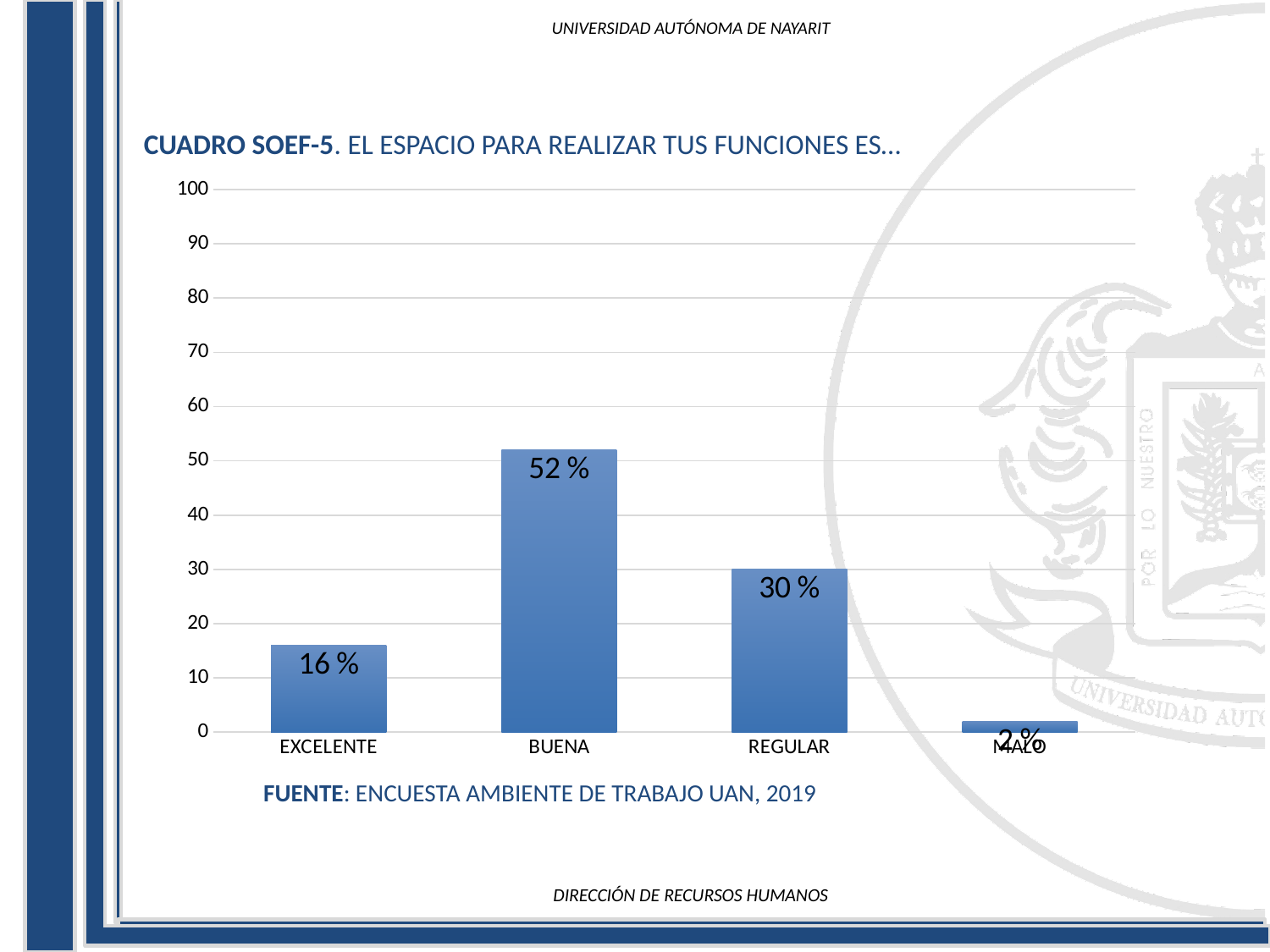
Which category has the lowest value? MALO What is the difference between the values for BUENA and REGULAR? 22 % What is the value for REGULAR? 30 % What is the source cited below the chart? ENCUESTA AMBIENTE DE TRABAJO UAN, 2019 Which category has the highest value? BUENA What kind of chart is shown on the slide? bar chart What is the value for EXCELENTE? 16 % How many categories are shown on the x axis? 4 Is the value for BUENA greater or less than 50? greater What is the value for BUENA? 52 % Which is larger, the value for EXCELENTE or the value for REGULAR? REGULAR What is the value for MALO? 2 %